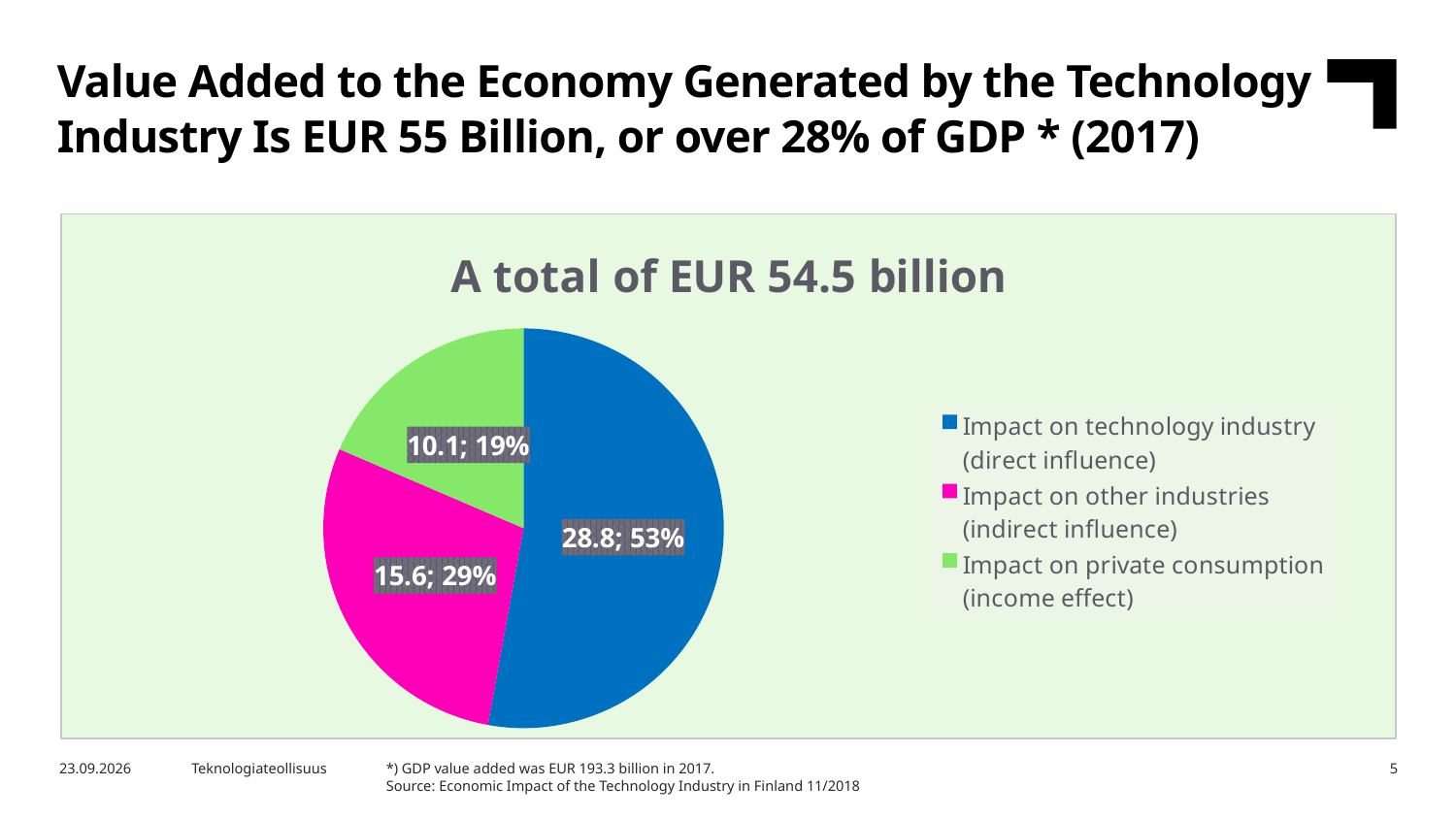
What value is shown for Impact on other industries (indirect influence)? 15.6 What share of the pie does Impact on technology industry (direct influence) represent? 53% How many slices does the pie chart have? 3 What value is shown for Impact on technology industry (direct influence)? 28.8 What kind of chart is shown on the slide? pie chart Which category has the smallest slice? Impact on private consumption (income effect) How many entries does the legend list? 3 Which category has the largest slice? Impact on technology industry (direct influence) What value is shown for Impact on private consumption (income effect)? 10.1 What share of the pie does Impact on private consumption (income effect) represent? 19% What is the chart's title? A total of EUR 54.5 billion What is the difference between the values for Impact on technology industry (direct influence) and Impact on other industries (indirect influence)? 13.2